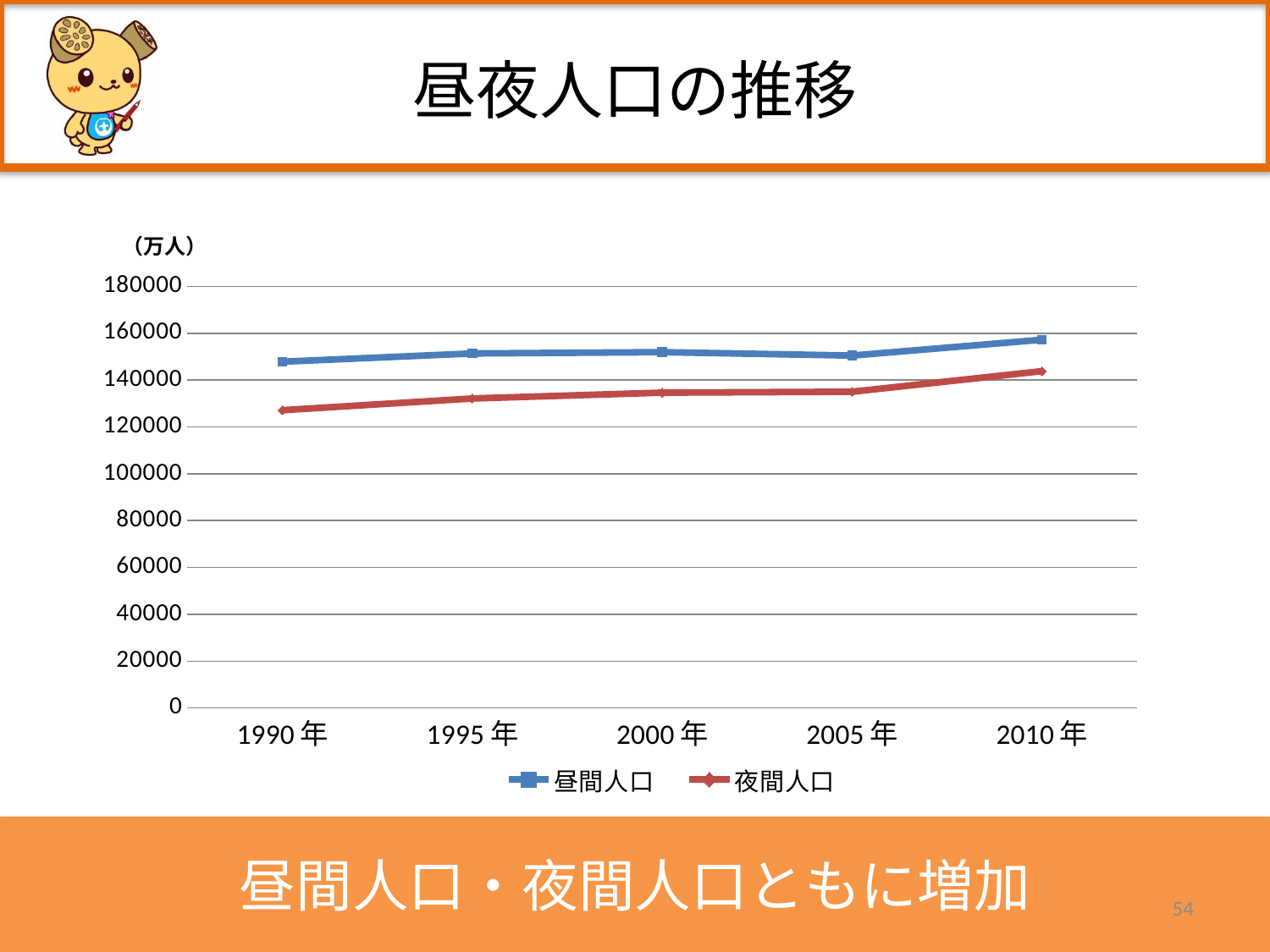
Is the value for 夜間人口 in 1990年 greater or less than 140000? less In 2000年, which is larger, 昼間人口 or 夜間人口? 昼間人口 What kind of chart is shown on the slide? Line chart Which series is drawn in blue according to the legend? 昼間人口 In which year is 昼間人口 highest? 2010年 How many years are plotted along the x axis? 5 Is the value for 夜間人口 in 2000年 greater or less than 120000? greater Does 夜間人口 rise or fall from 1990年 to 2010年? rise How many series does the legend list? 2 What is the title of the chart on the slide? 昼夜人口の推移 In which year is 夜間人口 lowest? 1990年 Is the value for 昼間人口 in 1990年 greater or less than 140000? greater